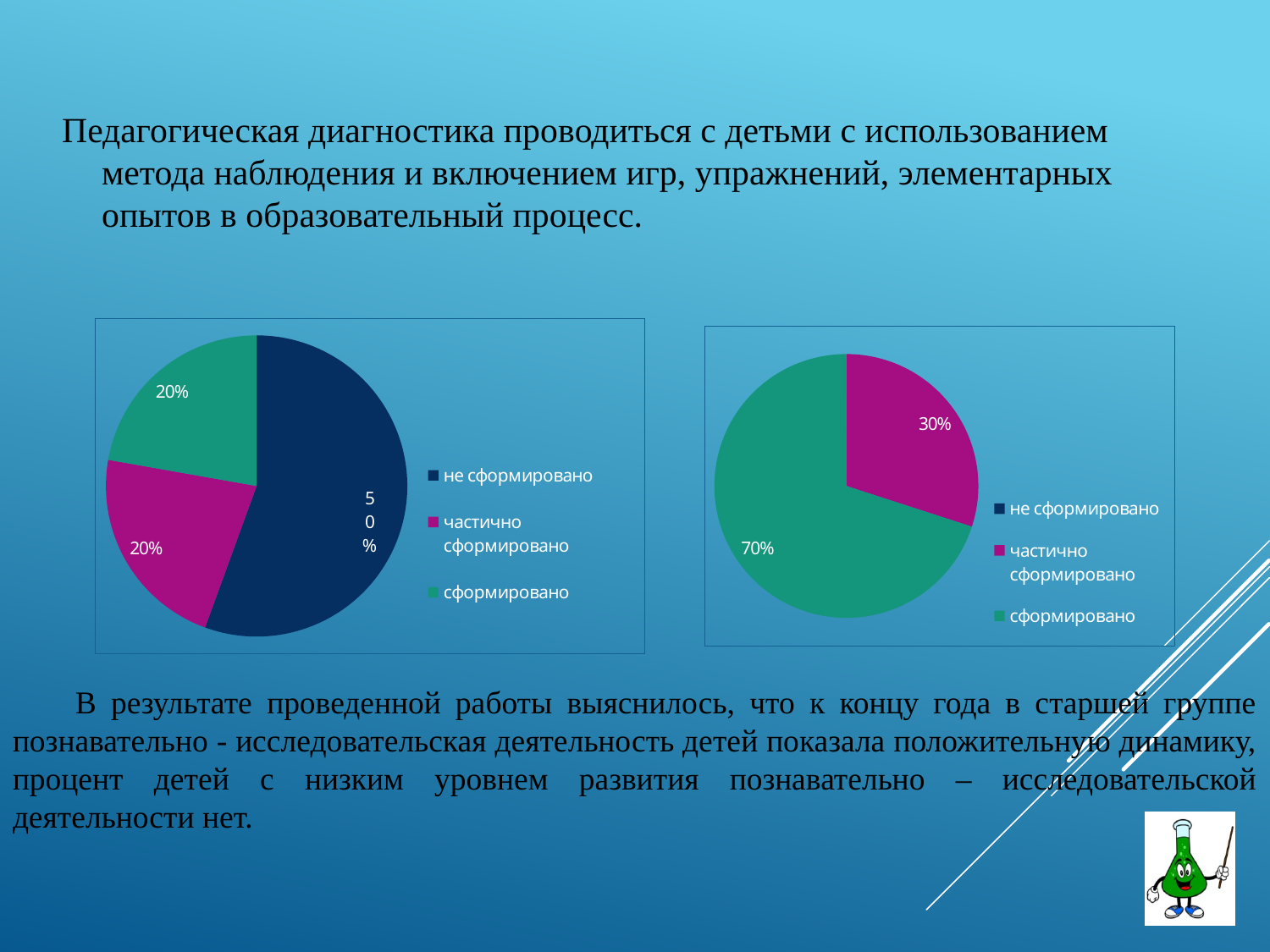
On the right pie chart, what is the difference between 'сформировано' and 'частично сформировано'? 40% On the left pie chart, what is the difference between 'не сформировано' and 'сформировано'? 30% On the right pie chart, which category has the largest slice? сформировано On the left pie chart, what colour is the 'сформировано' slice? green On the left pie chart, what is the value for 'не сформировано'? 50% What type of chart is shown on the left of the slide? pie chart On the right pie chart, what is the value for 'частично сформировано'? 30% On the left pie chart, what is the value for 'частично сформировано'? 20% On the right pie chart, which is larger: 'сформировано' or 'частично сформировано'? сформировано On the right pie chart, what is the value for 'сформировано'? 70% On the left pie chart, which category has the largest slice? не сформировано How many entries does the legend of the right pie chart list? 3